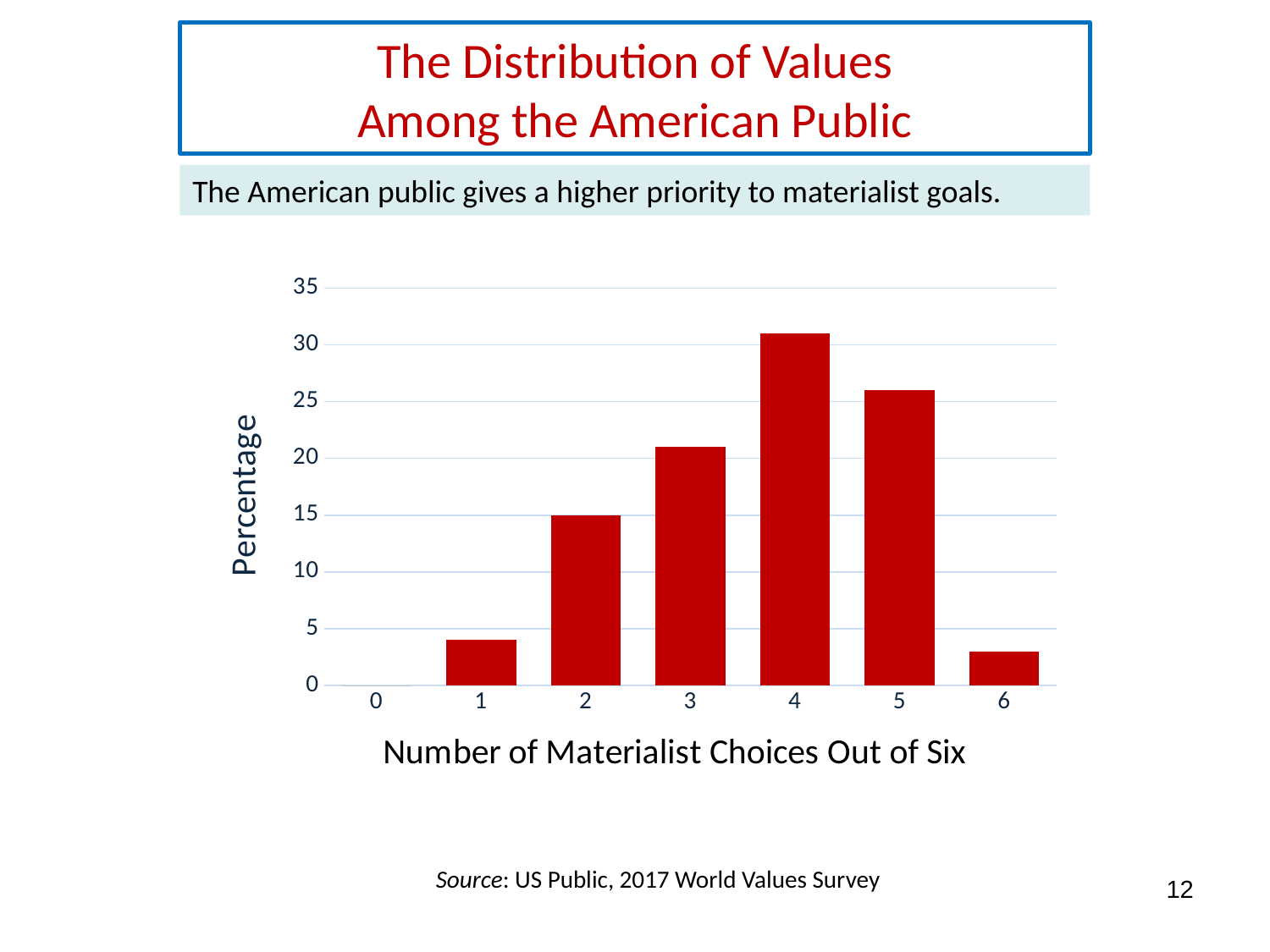
Is the percentage for 4 materialist choices greater or less than 30? greater What kind of chart is shown on the slide? bar chart How many categories are shown on the x axis of the chart? 7 What is the label on the y axis of the chart? Percentage Is the percentage for 5 materialist choices greater or less than 25? greater Which number of materialist choices has the highest percentage? 4 What is the percentage for 2 materialist choices? 15 Is the percentage for 3 materialist choices greater or less than 20? greater Do the percentages rise or fall from 1 to 4 materialist choices? rise Which has a higher percentage, 4 materialist choices or 5 materialist choices? 4 Which has a higher percentage, 2 materialist choices or 3 materialist choices? 3